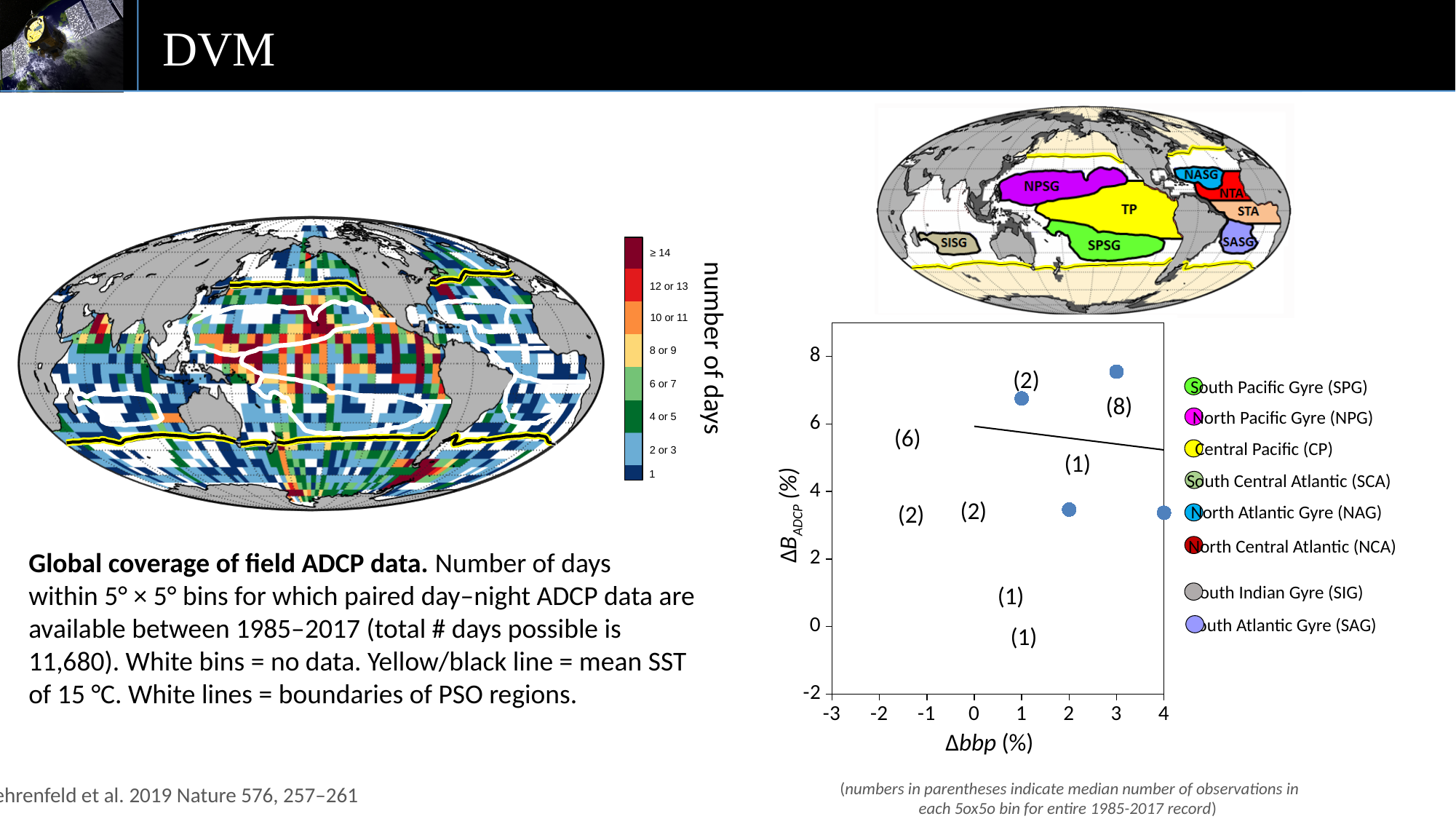
In the scatter chart on the right, is the ΔB_ADCP value of the point at Δbbp = 3 greater or less than 6? greater In the map on the left, how many categories does the 'number of days' colour scale list? 8 What kind of chart is the chart on the right of the slide with axes Δbbp (%) and ΔB_ADCP (%)? scatter chart In the scatter chart on the right, how many regions does the legend list? 8 In the map on the left, what is the label of the top (dark red) category of the 'number of days' colour scale? ≥ 14 In the scatter chart on the right, how many parenthetical observation-count labels are shown in the plot area? 8 In the scatter chart on the right, is the ΔB_ADCP value of the point at Δbbp = 2 greater or less than 4? less In the scatter chart on the right, what is the largest number shown in parentheses next to a point? (8) In the scatter chart on the right, what is the highest tick value shown on the Δbbp (%) axis? 4 In the scatter chart on the right, is the ΔB_ADCP value of the point at Δbbp = 1 greater or less than 6? greater In the scatter chart on the right, which of the two points at Δbbp = 3 and Δbbp = 2 has the higher ΔB_ADCP value? the point at Δbbp = 3